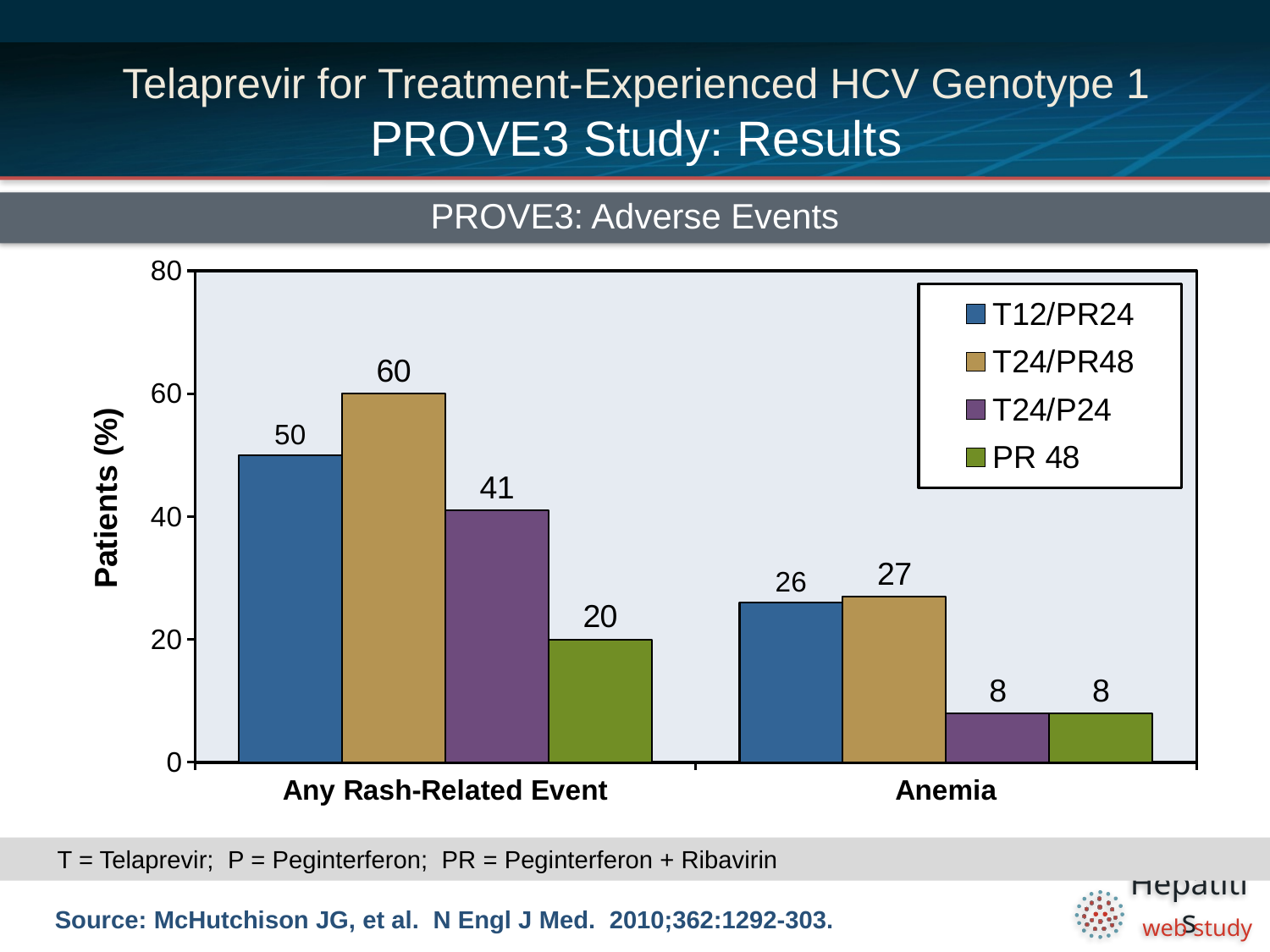
Is the value for T24/P24 in the Anemia category greater or less than 20? less Which series has the highest value in the Any Rash-Related Event category? T24/PR48 Which is larger: the T12/PR24 value for Any Rash-Related Event or the T12/PR24 value for Anemia? Any Rash-Related Event Which series has the lowest value in the Any Rash-Related Event category? PR 48 What is the value for T12/PR24 in the Any Rash-Related Event category? 50 What is the label of the y axis? Patients (%) What is the value for T24/PR48 in the Anemia category? 27 How many categories are shown on the x axis? 2 What is the difference between the T24/PR48 and T24/P24 values in the Any Rash-Related Event category? 19 How many series does the legend list? 4 What is the value for PR 48 in the Any Rash-Related Event category? 20 What kind of chart is shown on the slide? bar chart